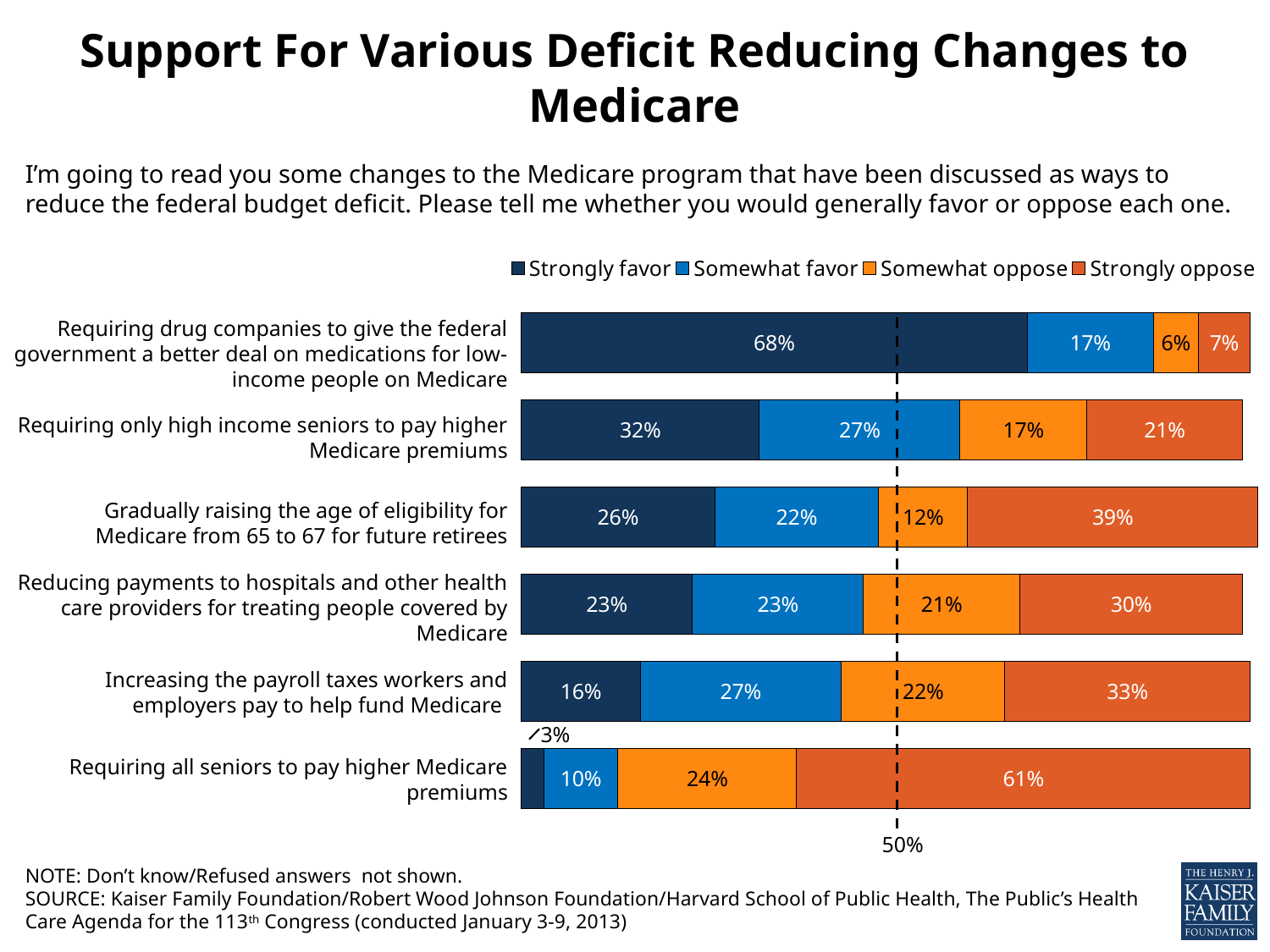
What is the difference between the 'Strongly oppose' percentages for requiring all seniors to pay higher Medicare premiums and for gradually raising the age of eligibility for Medicare? 22% What percentage somewhat oppose gradually raising the age of eligibility for Medicare from 65 to 67 for future retirees? 12% Which proposal has the highest 'Strongly favor' percentage? Requiring drug companies to give the federal government a better deal on medications for low-income people on Medicare What value does the dashed vertical line in the chart mark? 50% What is the combined 'Strongly favor' and 'Somewhat favor' percentage for increasing the payroll taxes workers and employers pay to help fund Medicare? 43% What percentage strongly favor requiring drug companies to give the federal government a better deal on medications for low-income people on Medicare? 68% What kind of chart is shown on the slide? Stacked bar chart What percentage strongly oppose requiring all seniors to pay higher Medicare premiums? 61% How many proposals (categories) are shown in the chart? 6 How many series does the legend list? 4 Which proposal has the lowest 'Strongly favor' percentage? Requiring all seniors to pay higher Medicare premiums Which is larger: the 'Somewhat favor' percentage for requiring only high income seniors to pay higher Medicare premiums, or the 'Somewhat favor' percentage for gradually raising the age of eligibility for Medicare? Requiring only high income seniors to pay higher Medicare premiums